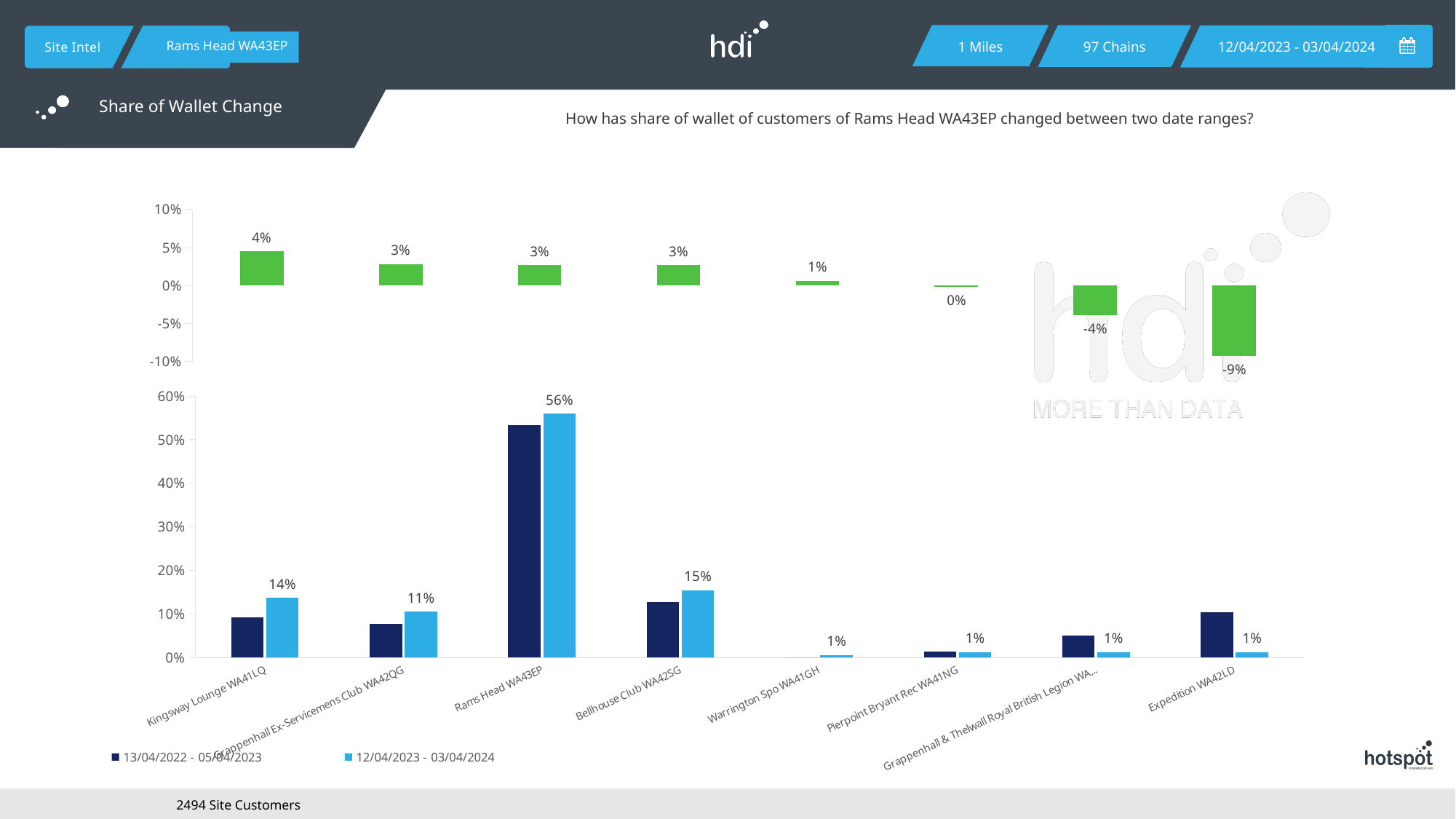
What kind of chart is the bottom chart? bar chart In the bottom chart, what is the 12/04/2023 - 03/04/2024 value for Rams Head WA43EP? 56% How many series does the legend of the bottom chart list? 2 In the top chart (share of wallet change), what is the difference between the values for Kingsway Lounge WA41LQ and Expedition WA42LD? 13% In the bottom chart, which site has the highest 12/04/2023 - 03/04/2024 value? Rams Head WA43EP In the bottom chart, what is the difference between the 12/04/2023 - 03/04/2024 values for Bellhouse Club WA42SG and Kingsway Lounge WA41LQ? 1% In the top chart (share of wallet change), what is the value for Kingsway Lounge WA41LQ? 4% In the bottom chart, is the 13/04/2022 - 05/04/2023 value for Rams Head WA43EP greater or less than 50%? greater In the bottom chart, which is larger for 12/04/2023 - 03/04/2024: Bellhouse Club WA42SG or Grappenhall Ex-Servicemens Club WA42QG? Bellhouse Club WA42SG In the top chart (share of wallet change), which site has the lowest value? Expedition WA42LD In the top chart (share of wallet change), which site has the highest value? Kingsway Lounge WA41LQ In the top chart (share of wallet change), what is the value for Grappenhall & Thelwall Royal British Legion? -4%